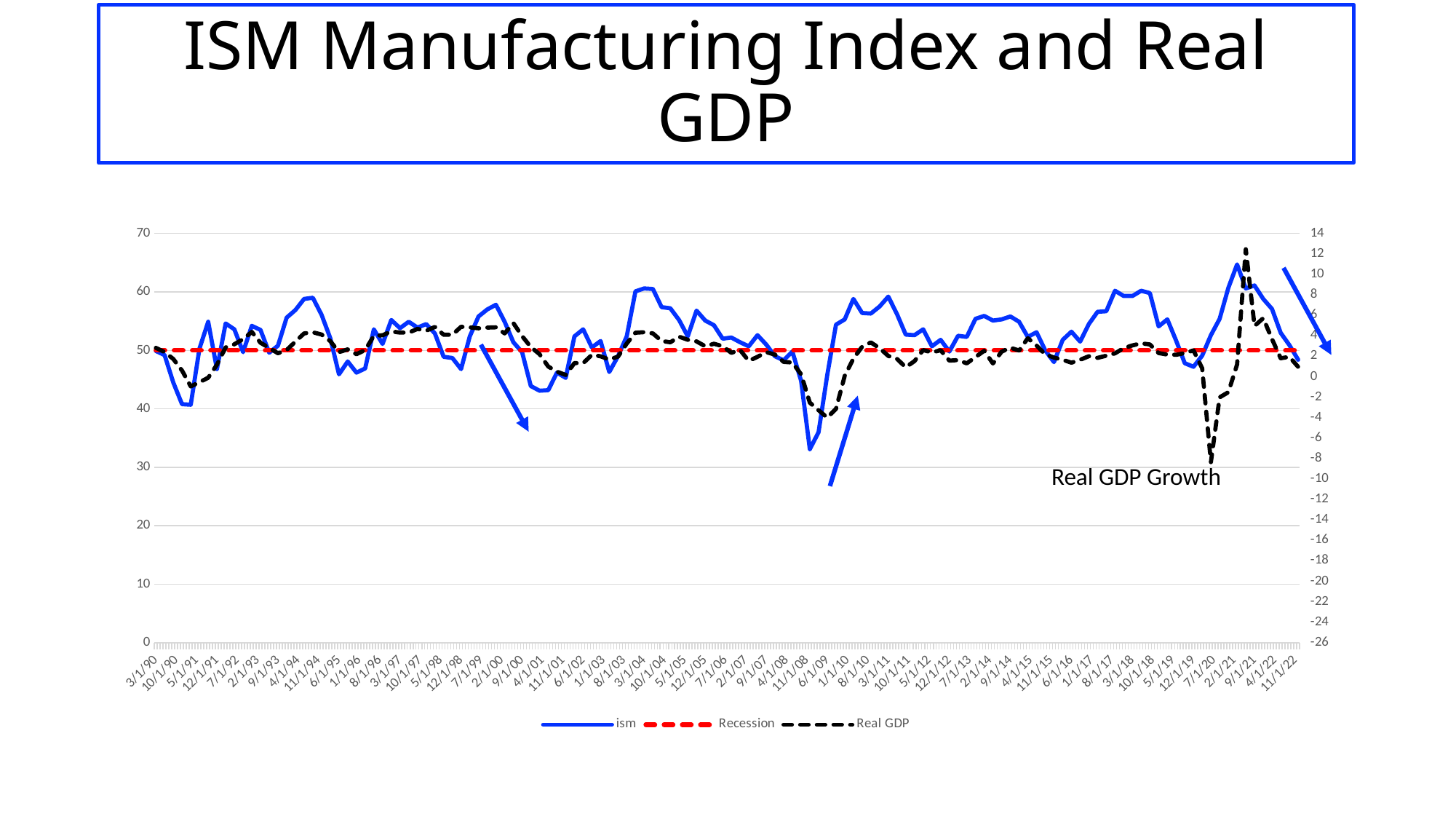
What are the three series named in the legend? ism, Recession, Real GDP At what level on the left axis does the red dashed Recession line stay constant? 50 Does the ism line rise or fall between 7/1/20 and 2/1/21? rise What is the title of the chart? ISM Manufacturing Index and Real GDP Does the ism line rise or fall between 2/1/21 and 11/1/22? fall How many series does the legend list? 3 Is the ism value around 10/1/90 greater or less than 50? less What kind of chart is shown on the slide? line chart Is the Real GDP value around 7/1/20 greater or less than -6 on the right axis? less Is the ism value around 2/1/21 greater or less than 60? greater